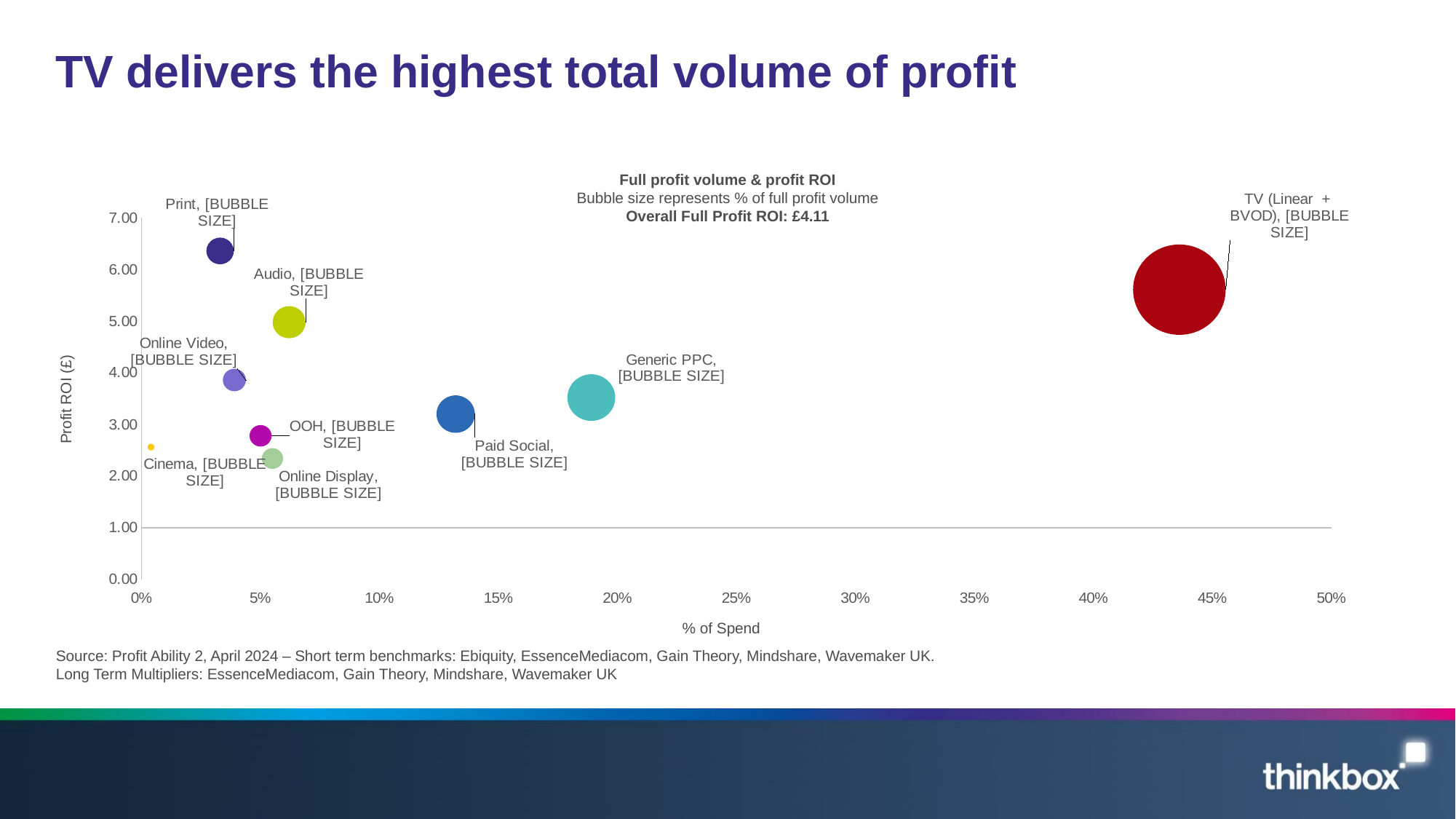
Which channel has the largest bubble, i.e. the largest share of full profit volume? TV (Linear + BVOD) Which has the higher Profit ROI, Audio or Paid Social? Audio How many media channels (bubbles) are plotted on the chart? 9 What kind of chart is shown on the slide? bubble chart Which has the higher % of Spend, Generic PPC or Paid Social? Generic PPC Which channel has the highest % of Spend on the chart? TV (Linear + BVOD) Which channel has the smallest bubble on the chart? Cinema Is the Profit ROI for Print greater or less than 6.00? greater Is the Profit ROI for TV (Linear + BVOD) greater or less than 5.00? greater What Overall Full Profit ROI is stated in the chart's subtitle? £4.11 Which channel has the highest Profit ROI on the chart? Print Is the % of Spend for Paid Social greater or less than 15%? less